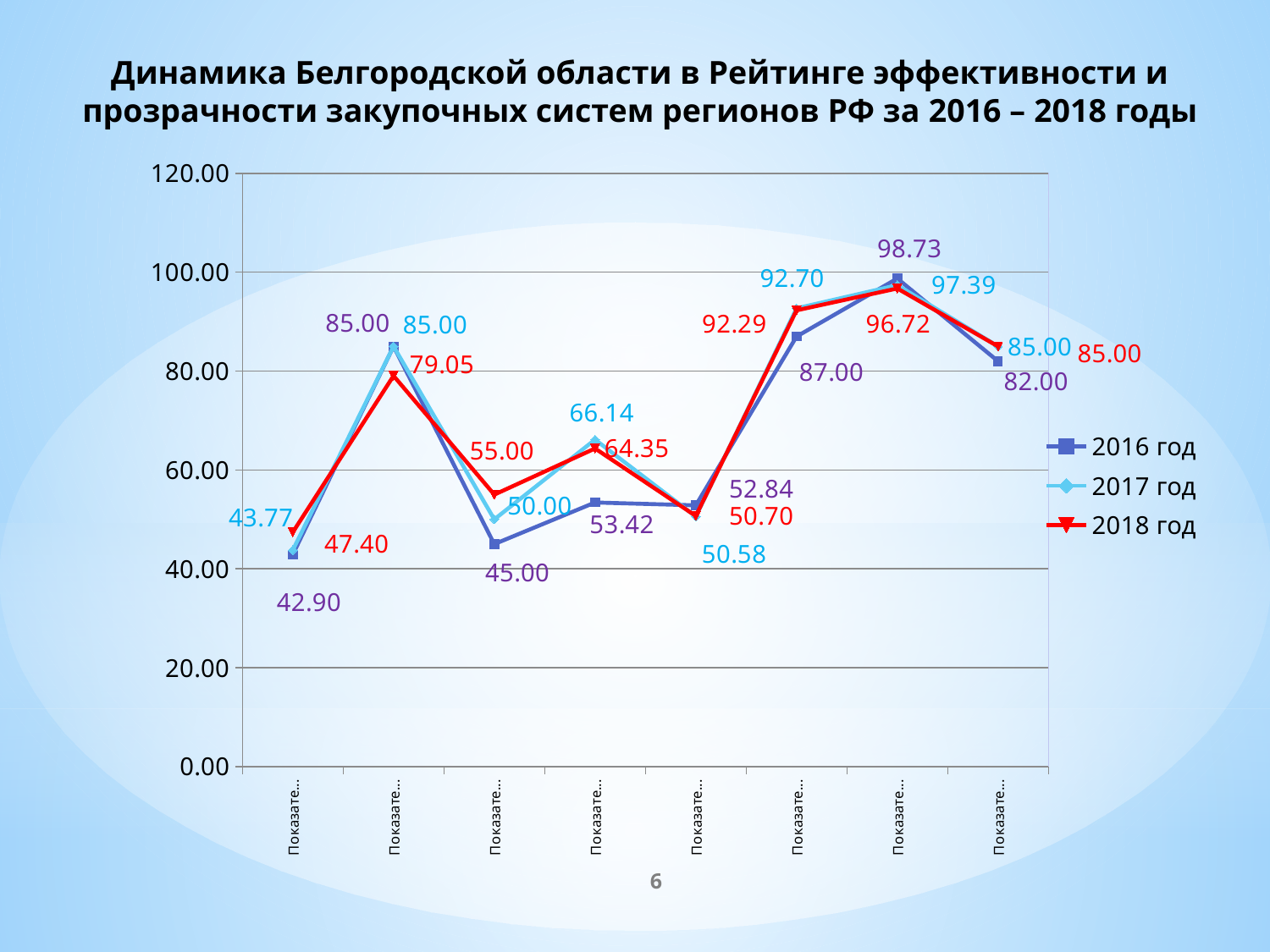
How many series does the legend list? 3 How many data points does each line have along the x axis? 8 Which series is drawn in red with triangle markers? 2018 год What is the lowest value plotted for the 2016 год series? 42.90 Is the value of the 2016 год series at the sixth point from the left greater or less than 80.00? greater At the fourth point from the left, which series has the larger value: 2016 год or 2017 год? 2017 год What is the value of the 2016 год series at the seventh point from the left? 98.73 What is the value of the 2017 год series at the fourth point from the left? 66.14 What is the difference between the 2018 год and 2016 год values at the third point from the left (55.00 and 45.00)? 10.00 What kind of chart is shown on the slide? line chart What is the highest value plotted for the 2016 год series? 98.73 What is the value of the 2018 год series at the first point from the left? 47.40